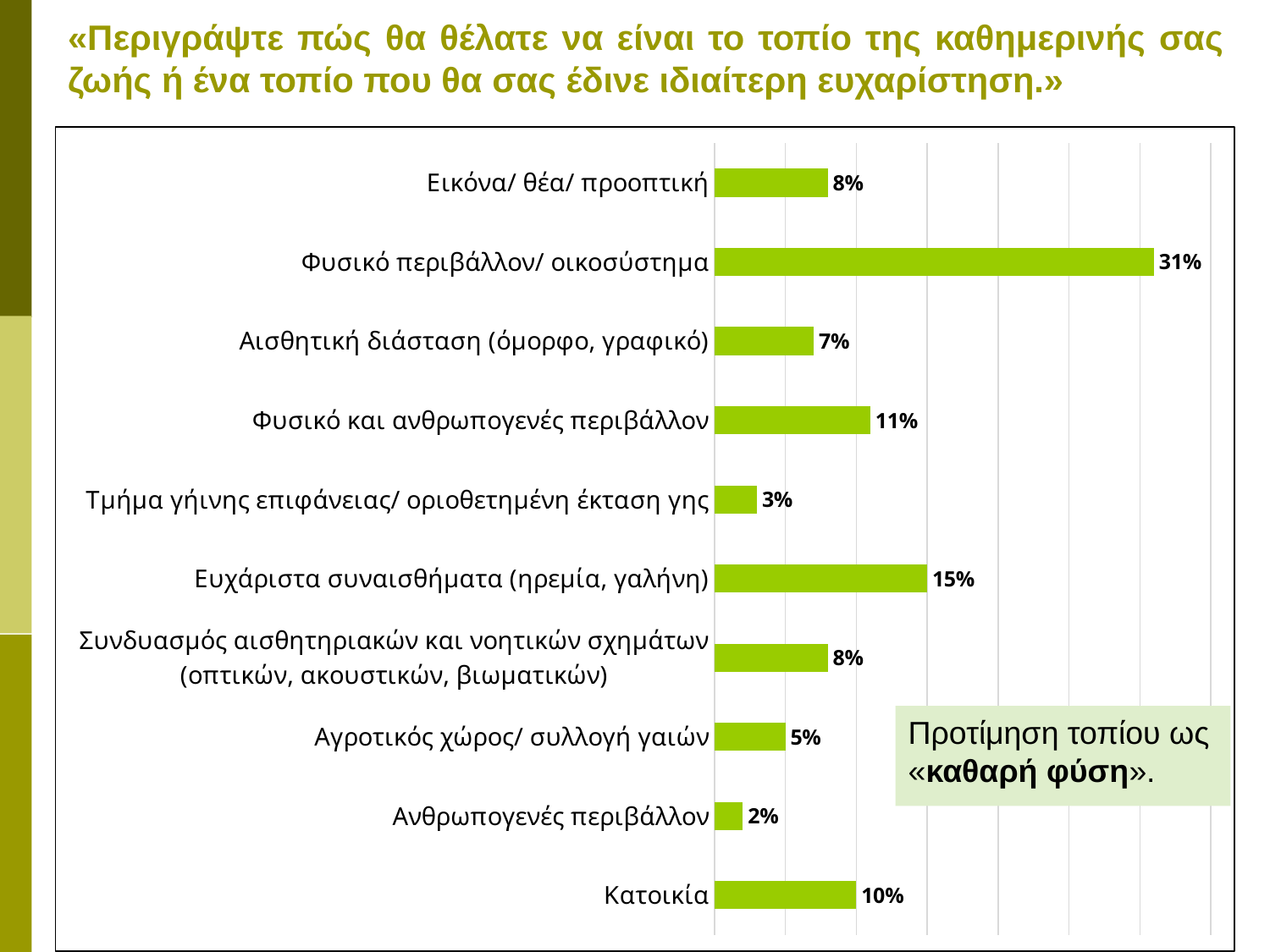
Which category has the highest value? Φυσικό περιβάλλον/ οικοσύστημα What is the difference between the values for Φυσικό και ανθρωπογενές περιβάλλον and Κατοικία? 1% What value is shown for Φυσικό περιβάλλον/ οικοσύστημα? 31% What value is shown for Κατοικία? 10% How many categories are shown in the chart? 10 What value is shown for Αγροτικός χώρος/ συλλογή γαιών? 5% What kind of chart is shown on the slide? Bar chart What is the difference between the values for Φυσικό περιβάλλον/ οικοσύστημα and Ευχάριστα συναισθήματα (ηρεμία, γαλήνη)? 16% Which category has the lowest value? Ανθρωπογενές περιβάλλον Which is larger, the value for Αισθητική διάσταση (όμορφο, γραφικό) or the value for Κατοικία? Κατοικία What colour are the bars in the chart? Green What value is shown for Ευχάριστα συναισθήματα (ηρεμία, γαλήνη)? 15%